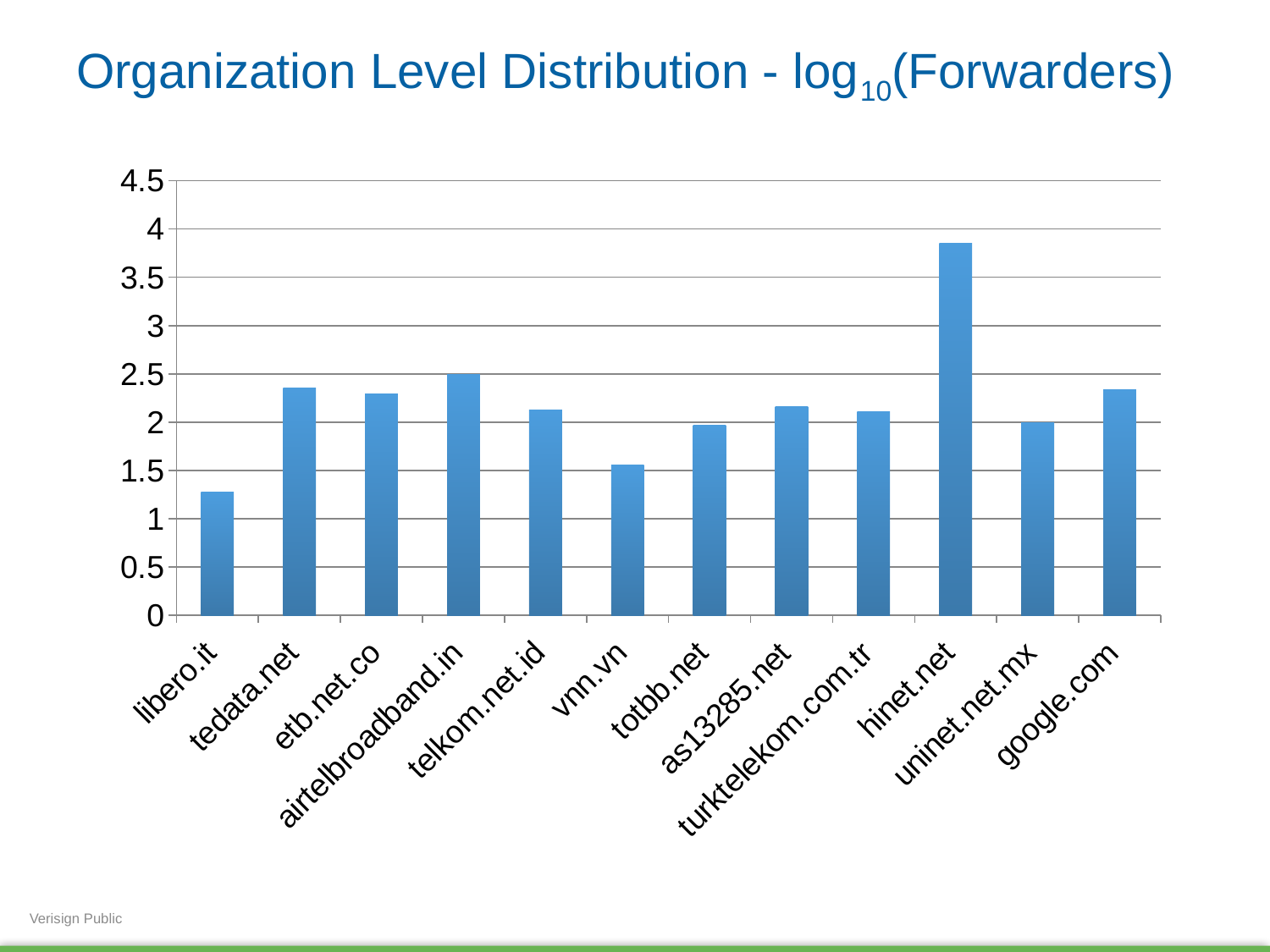
How many organizations are shown on the x axis of the chart? 12 Is the value for tedata.net greater or less than 2? greater Which has a larger value, hinet.net or google.com? hinet.net Is the value for vnn.vn greater or less than 2? less Which has a larger value, airtelbroadband.in or telkom.net.id? airtelbroadband.in Which organization has the highest value in the chart? hinet.net Which has a larger value, libero.it or vnn.vn? vnn.vn Which organization has the lowest value in the chart? libero.it What kind of chart is shown on the slide? bar chart Is the value for libero.it greater or less than 1.5? less What is the title of the slide containing the chart? Organization Level Distribution - log10(Forwarders)